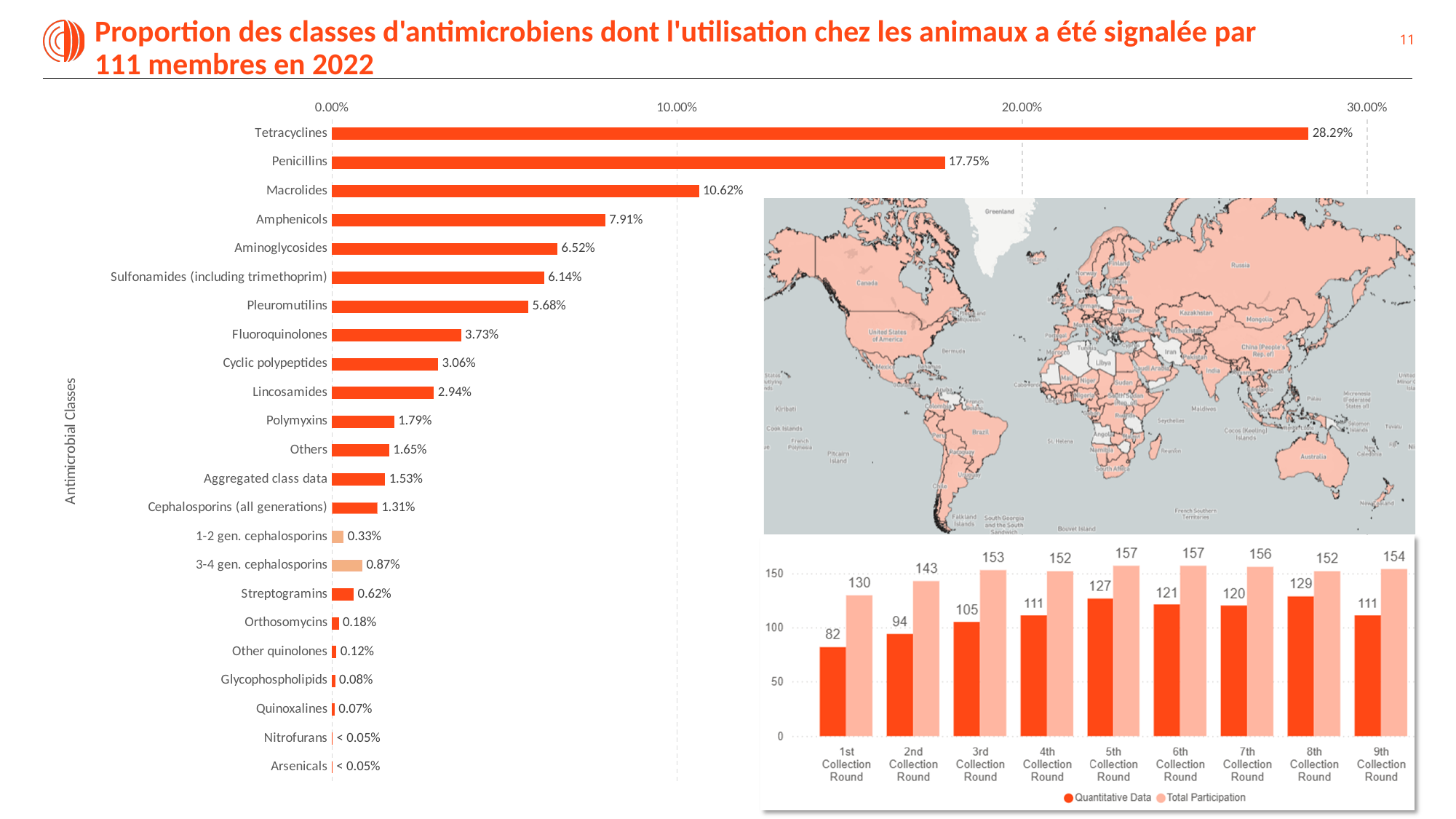
In the main bar chart of antimicrobial classes, what is the value for Pleuromutilins? 5.68% In the inset chart of collection rounds at the bottom right, what is the Total Participation value for the 1st Collection Round? 130 In the main bar chart of antimicrobial classes, which class has the highest proportion? Tetracyclines What kind of chart is the main chart of antimicrobial classes? Bar chart In the inset chart of collection rounds at the bottom right, what is the difference between Total Participation and Quantitative Data in the 9th Collection Round? 43 In the inset chart of collection rounds at the bottom right, how many series does the legend list? 2 In the main bar chart of antimicrobial classes, what is the value for Tetracyclines? 28.29% In the main bar chart of antimicrobial classes, which is larger, Amphenicols or Aminoglycosides? Amphenicols In the main bar chart of antimicrobial classes, what is the difference between Penicillins and Macrolides? 7.13% In the inset chart of collection rounds at the bottom right, which collection round has the lowest Quantitative Data value? 1st Collection Round In the main bar chart of antimicrobial classes, how many antimicrobial classes are listed? 23 In the inset chart of collection rounds at the bottom right, what is the Quantitative Data value for the 5th Collection Round? 127